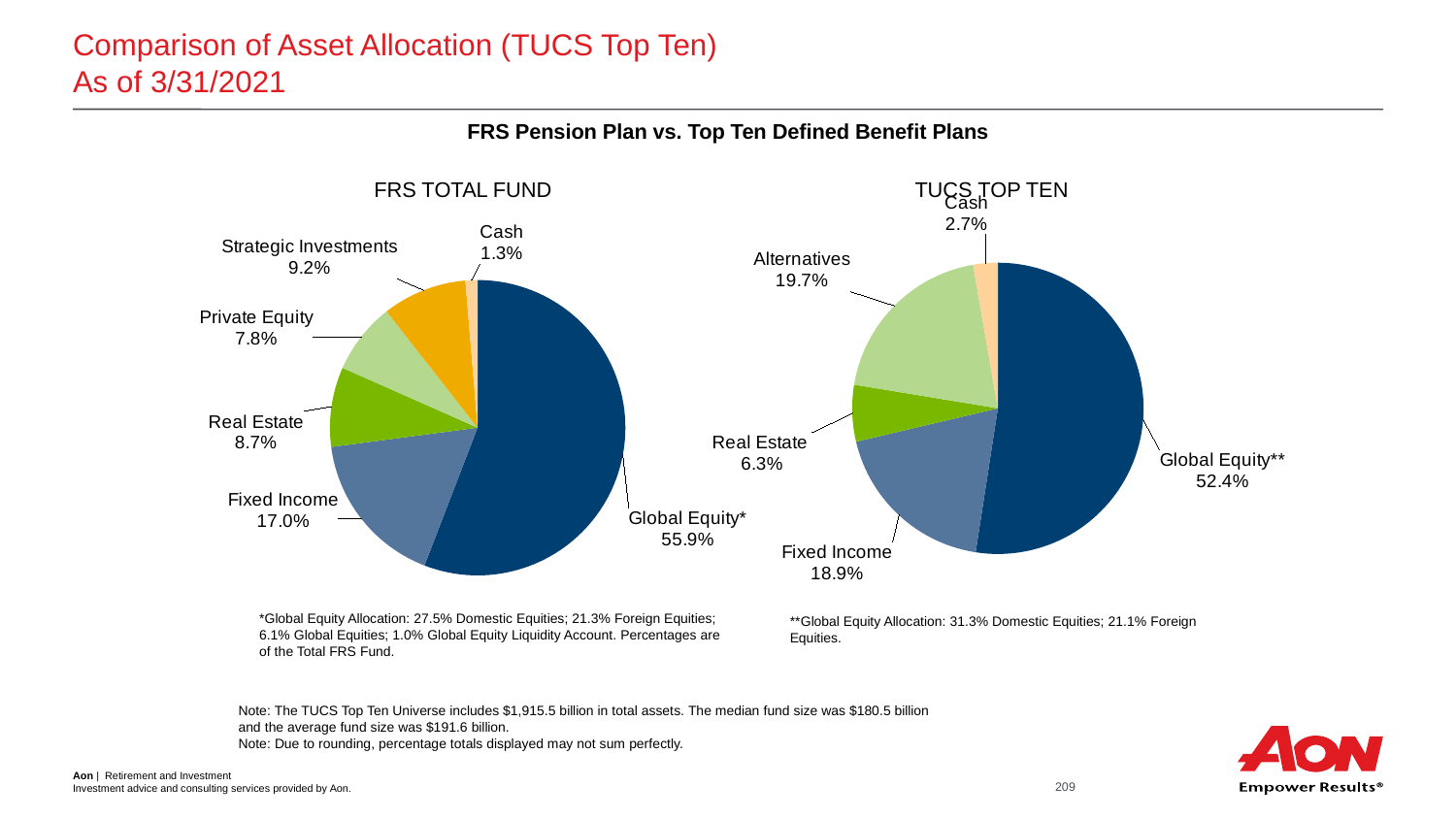
How many categories are shown in the FRS TOTAL FUND pie chart? 6 In the TUCS TOP TEN pie chart, what is the share for Cash? 2.7% In the FRS TOTAL FUND pie chart, which is larger: Strategic Investments or Private Equity? Strategic Investments In the FRS TOTAL FUND pie chart, what is the share for Global Equity*? 55.9% In the FRS TOTAL FUND pie chart, which category has the smallest share? Cash In the TUCS TOP TEN pie chart, which category has the smallest share? Cash What is the difference between the Fixed Income share in the TUCS TOP TEN chart and the Fixed Income share in the FRS TOTAL FUND chart? 1.9% In the FRS TOTAL FUND pie chart, which category has the largest share? Global Equity* What type of chart is used for the FRS TOTAL FUND? Pie chart How many categories are shown in the TUCS TOP TEN pie chart? 5 In the TUCS TOP TEN pie chart, what is the share for Alternatives? 19.7% In the FRS TOTAL FUND pie chart, what is the share for Fixed Income? 17.0%